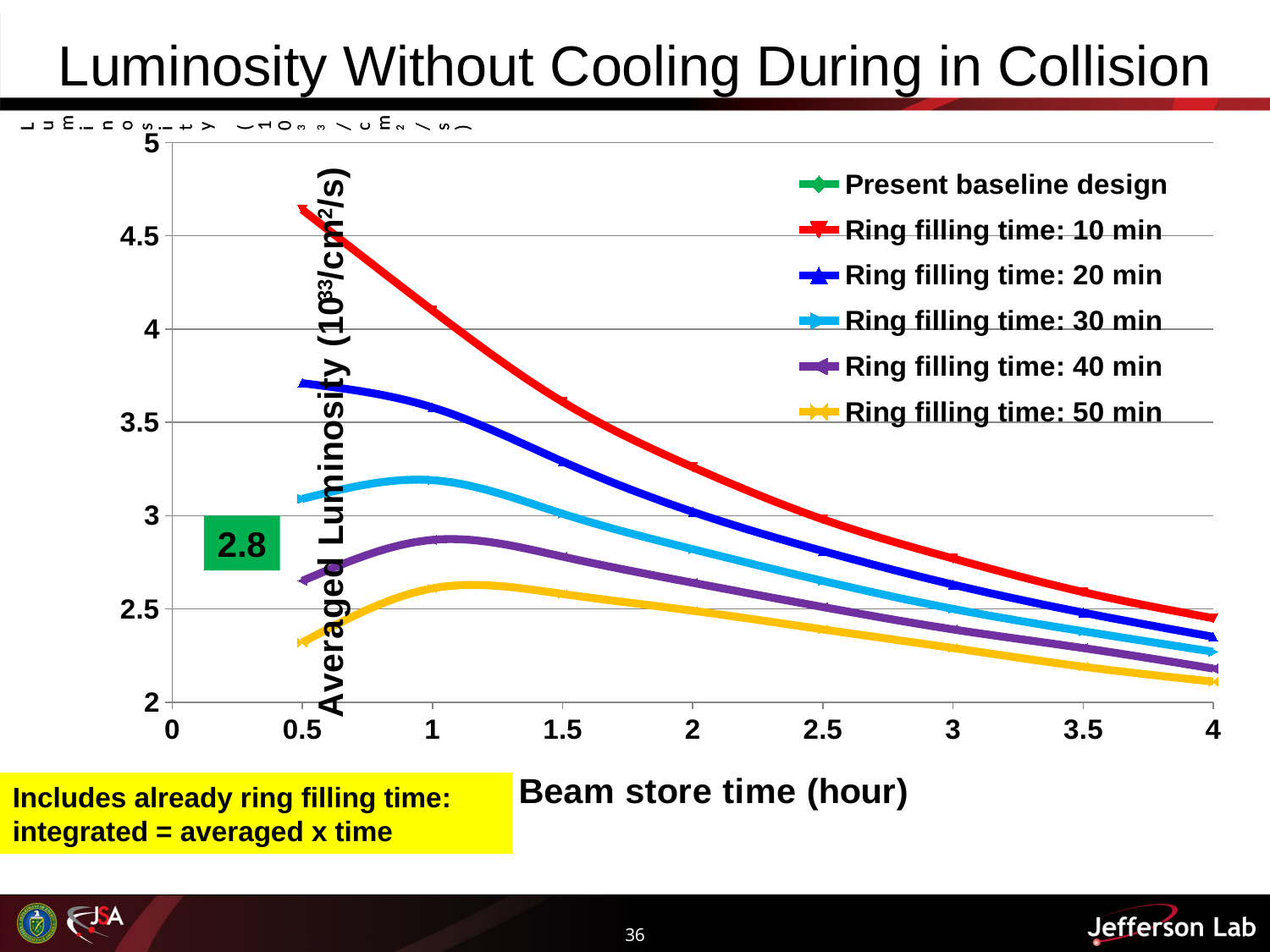
Is the value for Ring filling time: 20 min at 0.5 hour greater or less than 3.5? greater Is the value for Ring filling time: 50 min at 4 hours greater or less than 2.5? less How many series does the legend list? 6 What kind of chart is shown on the slide? line chart Which series has the highest averaged luminosity at a beam store time of 0.5 hour? Ring filling time: 10 min What colour is the line for Ring filling time: 10 min? red At a beam store time of 2 hours, which is larger: Ring filling time: 20 min or Ring filling time: 30 min? Ring filling time: 20 min What is the title of the x axis? Beam store time (hour) What value is shown for the Present baseline design? 2.8 Does the Ring filling time: 10 min series rise or fall as beam store time increases from 0.5 to 4 hours? fall Is the value for Ring filling time: 10 min at 0.5 hour greater or less than 4.5? greater Which series has the lowest averaged luminosity at a beam store time of 4 hours? Ring filling time: 50 min